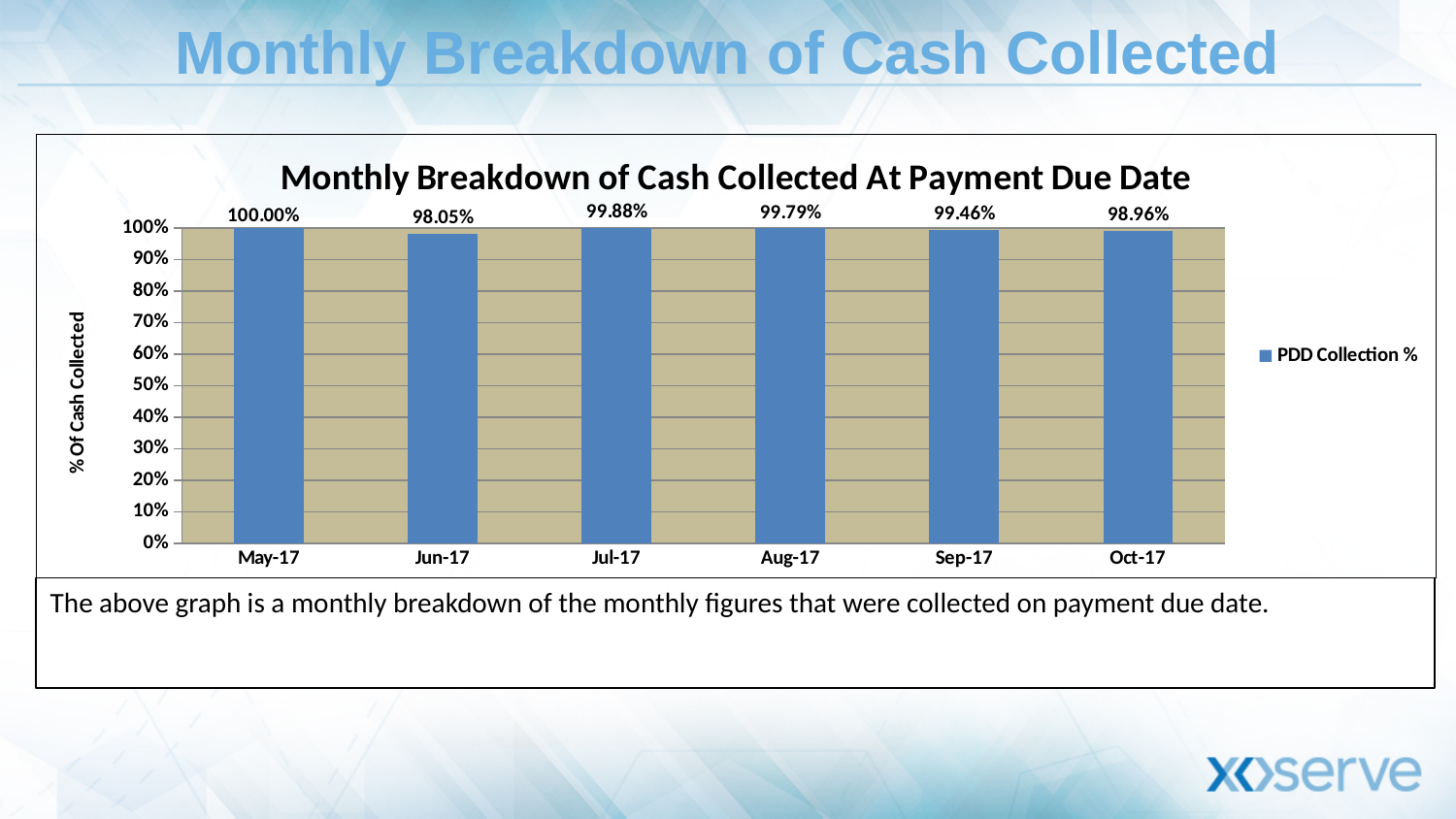
What kind of chart is shown on the slide? Bar chart What is the PDD Collection % for Jun-17? 98.05% Which month has the lowest PDD Collection %? Jun-17 Which month has a higher PDD Collection %, Sep-17 or Oct-17? Sep-17 How many series does the legend list? 1 What is the title of the chart? Monthly Breakdown of Cash Collected At Payment Due Date What is the difference between the PDD Collection % for Jul-17 and Aug-17? 0.09% How many months are shown on the x axis of the chart? 6 What is the PDD Collection % for Sep-17? 99.46% What is the difference between the PDD Collection % for May-17 and Jun-17? 1.95% What is the PDD Collection % for Oct-17? 98.96% Which month has the highest PDD Collection %? May-17